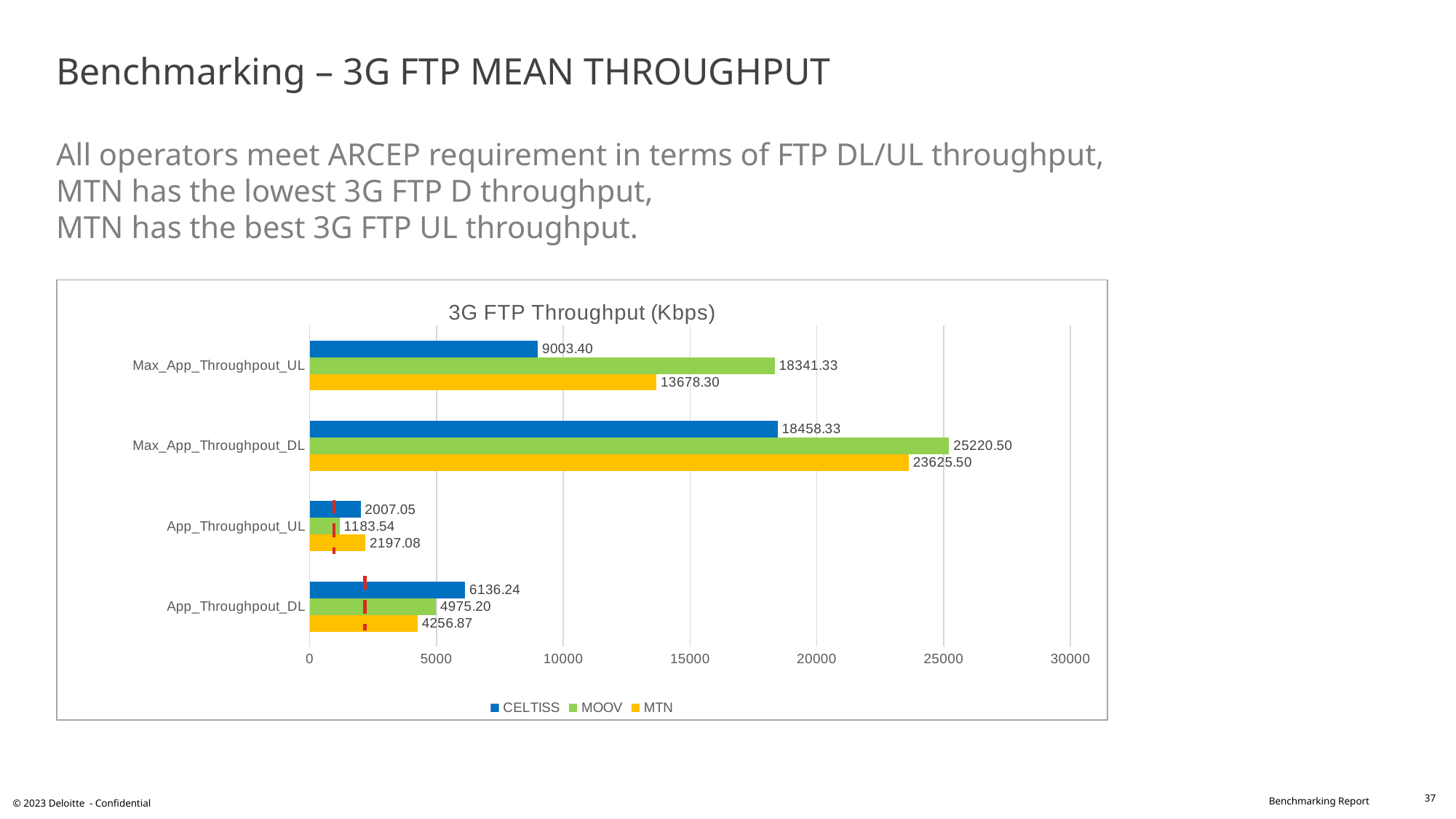
Is the CELTISS value for Max_App_Throughpout_UL greater or less than 10000? less What is the CELTISS value for App_Throughpout_DL? 6136.24 How many categories are shown on the vertical axis of the chart? 4 What is the MOOV value for Max_App_Throughpout_DL? 25220.50 What kind of chart is shown on the slide? Bar chart What is the MTN value for App_Throughpout_UL? 2197.08 Which is larger for App_Throughpout_UL: the CELTISS value or the MTN value? MTN What is the difference between the MOOV and MTN values for Max_App_Throughpout_DL? 1595.00 Which operator has the lowest value for App_Throughpout_DL? MTN How many series does the legend list? 3 What is the title of the chart? 3G FTP Throughput (Kbps) Which operator has the highest value for Max_App_Throughpout_UL? MOOV